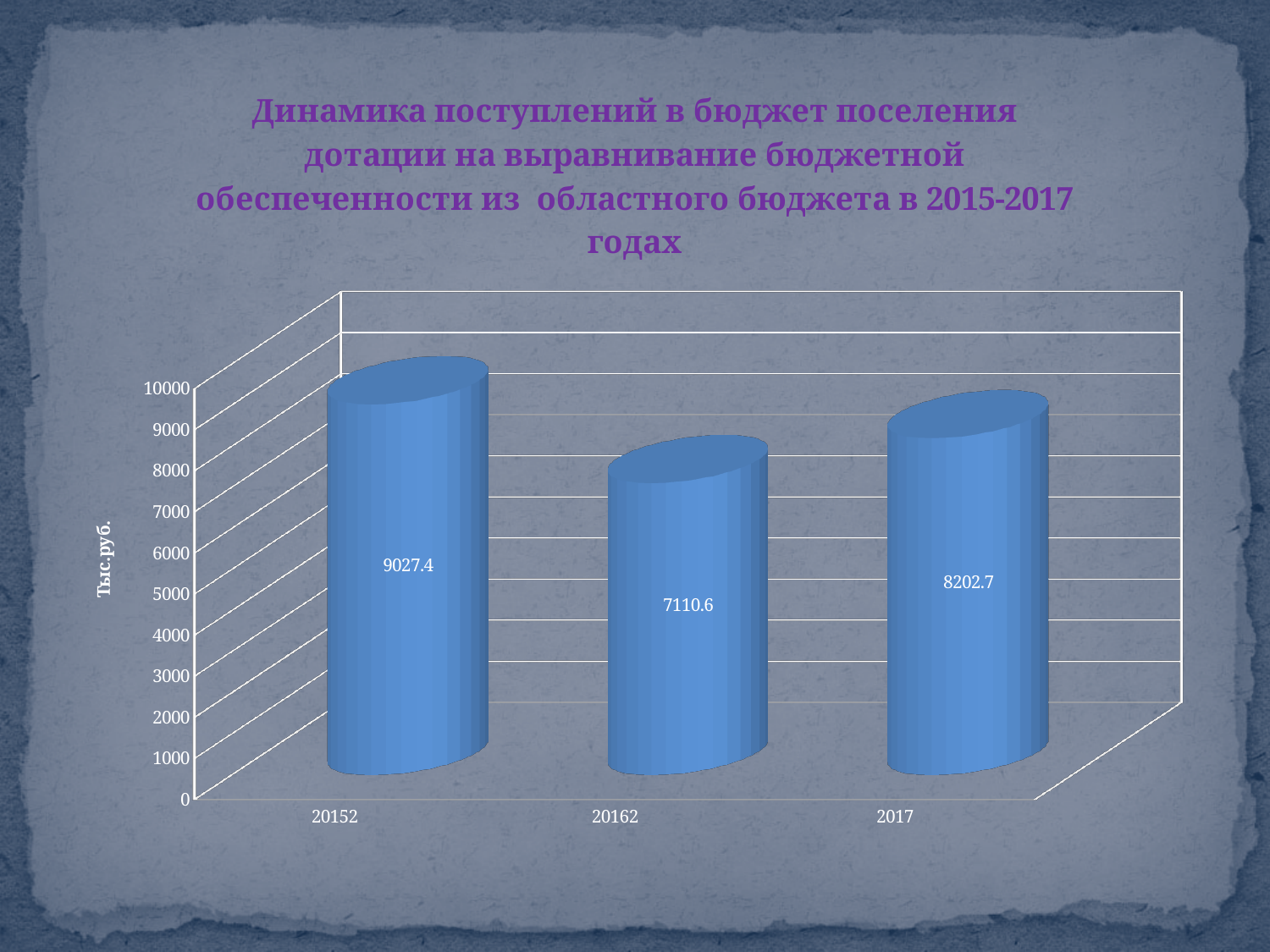
What is the value for 2017? 8202.7 Is the value for 2017 greater or less than 9000? less Which category has the lowest value? 20162 What is the value for the category labelled 20152? 9027.4 What kind of chart is shown on the slide? bar chart What is the label of the vertical axis? Тыс.руб. How many categories are shown on the x axis? 3 Which category has the highest value? 20152 What is the difference between the values for 20152 and 20162? 1916.8 What is the difference between the values for 2017 and 20162? 1092.1 What is the value for the category labelled 20162? 7110.6 Which is larger, the value for 2017 or the value for 20162? 2017